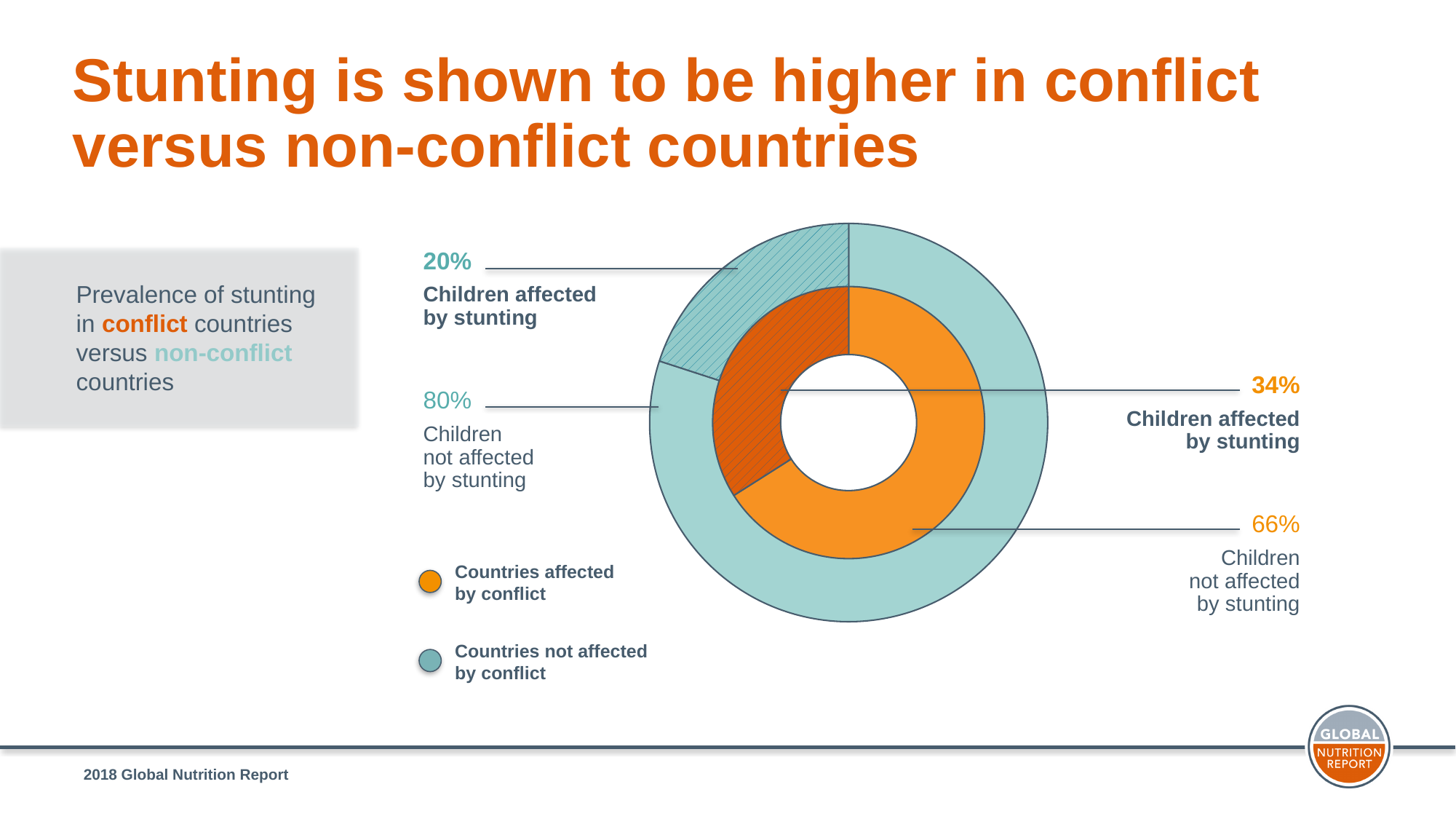
What percentage of children are affected by stunting in countries not affected by conflict? 20% Which group has a higher share of children not affected by stunting: countries affected by conflict or countries not affected by conflict? Countries not affected by conflict What percentage of children are not affected by stunting in countries affected by conflict? 66% How many groups of countries does the legend list? 2 Which group has a higher share of children affected by stunting: countries affected by conflict or countries not affected by conflict? Countries affected by conflict Which ring of the donut chart, inner or outer, represents countries not affected by conflict? Outer What type of chart is shown on the slide? Donut chart What percentage of children are not affected by stunting in countries not affected by conflict? 80% What is the difference in the share of children affected by stunting between conflict-affected countries and non-conflict countries? 14% What is the total of the two percentages shown for countries affected by conflict? 100% What percentage of children are affected by stunting in countries affected by conflict? 34% Which colour represents countries affected by conflict in the chart? Orange